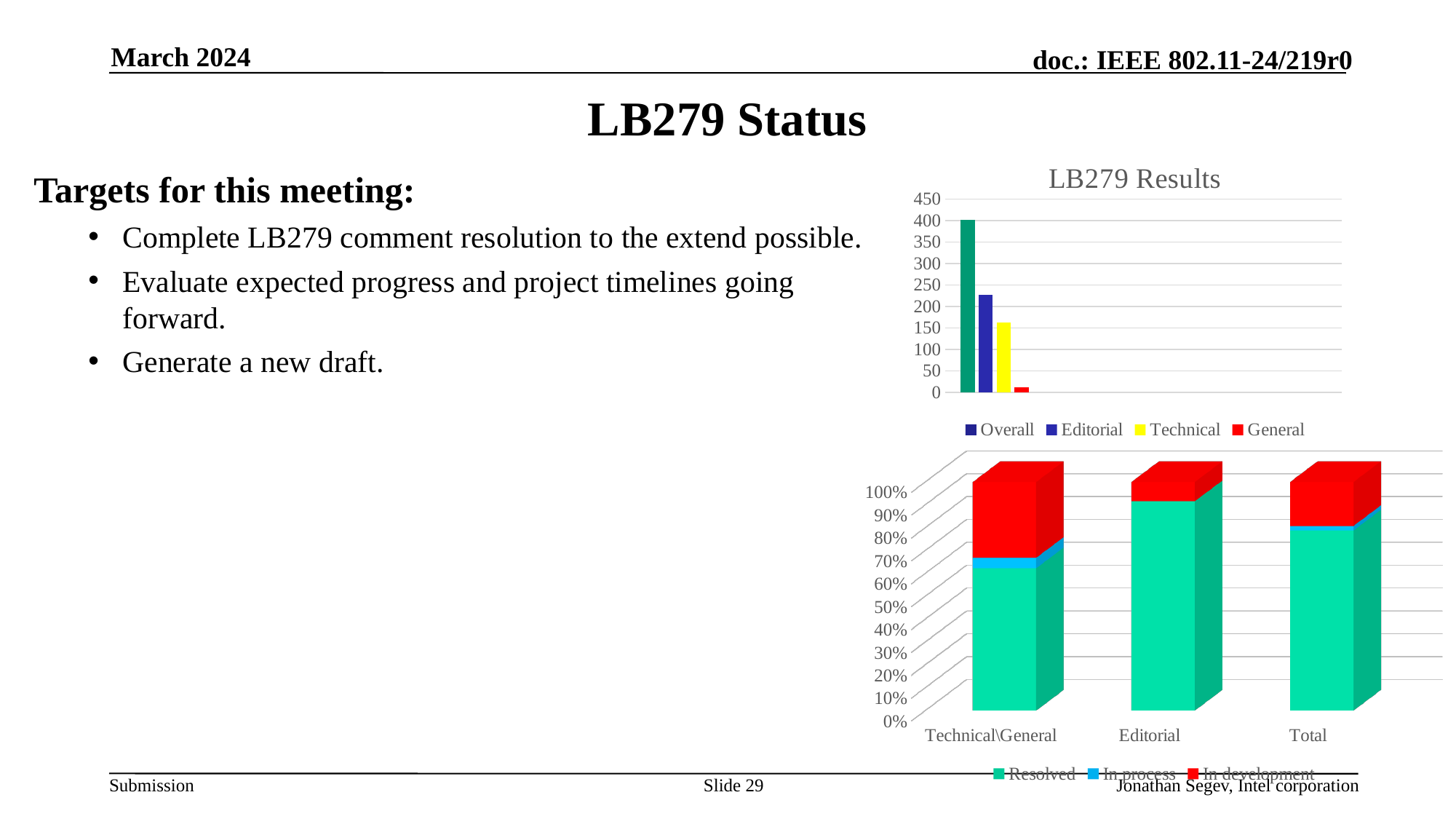
In the stacked bar chart at the bottom, how many series does the legend list? 3 In the LB279 Results chart at the top, what kind of chart is shown? bar chart In the LB279 Results chart at the top, is the value for Overall greater or less than 350? greater In the stacked bar chart at the bottom, which category has the largest In development share? Technical\General In the LB279 Results chart at the top, which series has the highest value? Overall In the stacked bar chart at the bottom, how many categories are shown on the x axis? 3 In the LB279 Results chart at the top, which is larger, Editorial or Technical? Editorial In the LB279 Results chart at the top, is the value for General greater or less than 50? less In the stacked bar chart at the bottom, which category has the largest Resolved share? Editorial In the LB279 Results chart at the top, is the value for Technical greater or less than 200? less In the LB279 Results chart at the top, how many series does the legend list? 4 In the LB279 Results chart at the top, which series has the lowest value? General